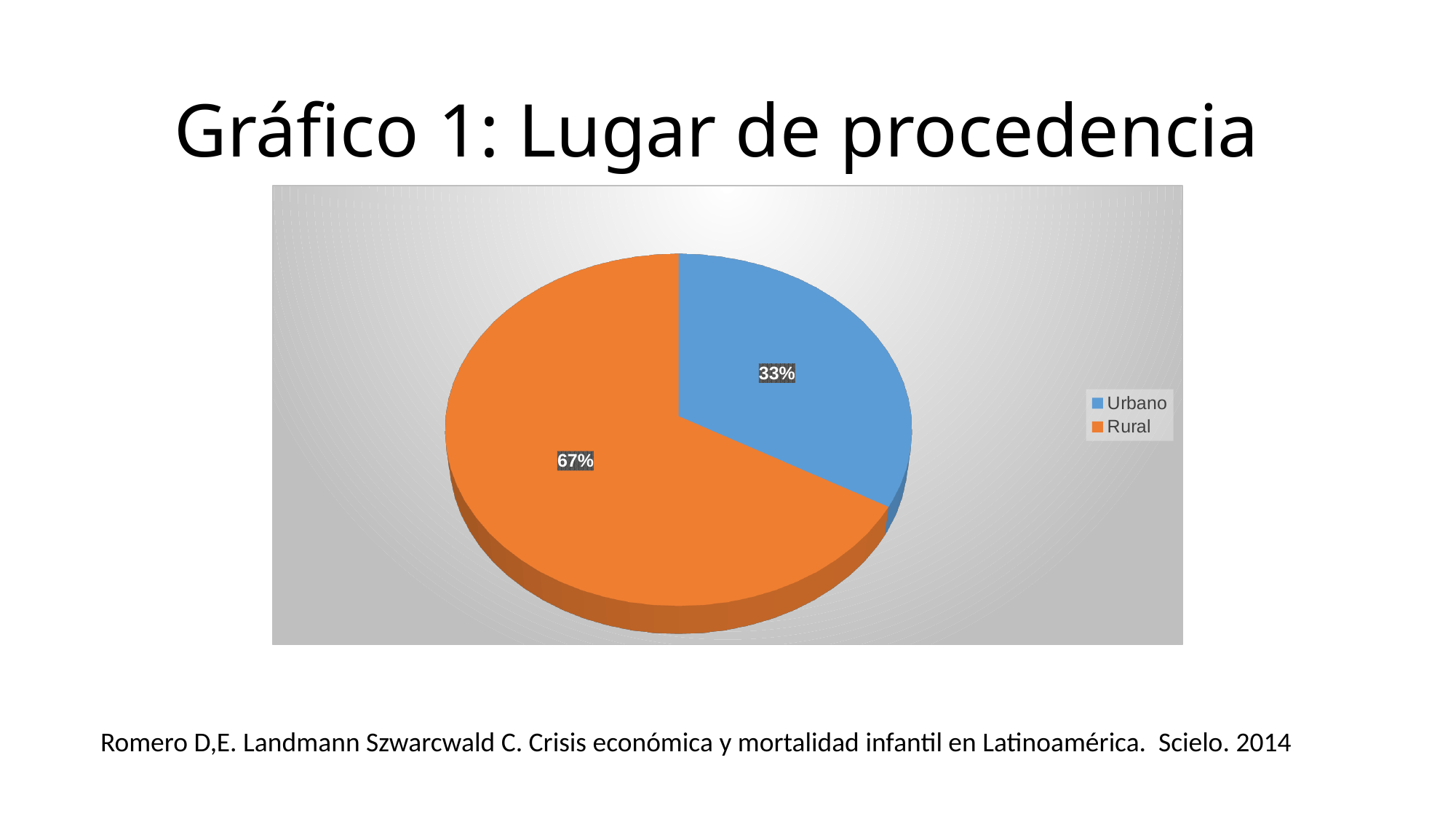
How many categories are shown in the pie chart? 2 What share of the pie does the Urbano slice represent? 33% What colour is the Rural slice in the pie chart? Orange What share of the pie does the Rural slice represent? 67% What kind of chart is shown on the slide? Pie chart What is the title of the slide containing the chart? Gráfico 1: Lugar de procedencia What is the difference in percentage points between the Rural and Urbano slices? 34 What is the total of the two slice percentages shown on the pie chart? 100% Which category has the largest slice of the pie? Rural Which category has the smallest slice of the pie? Urbano Which slice is larger, Urbano or Rural? Rural